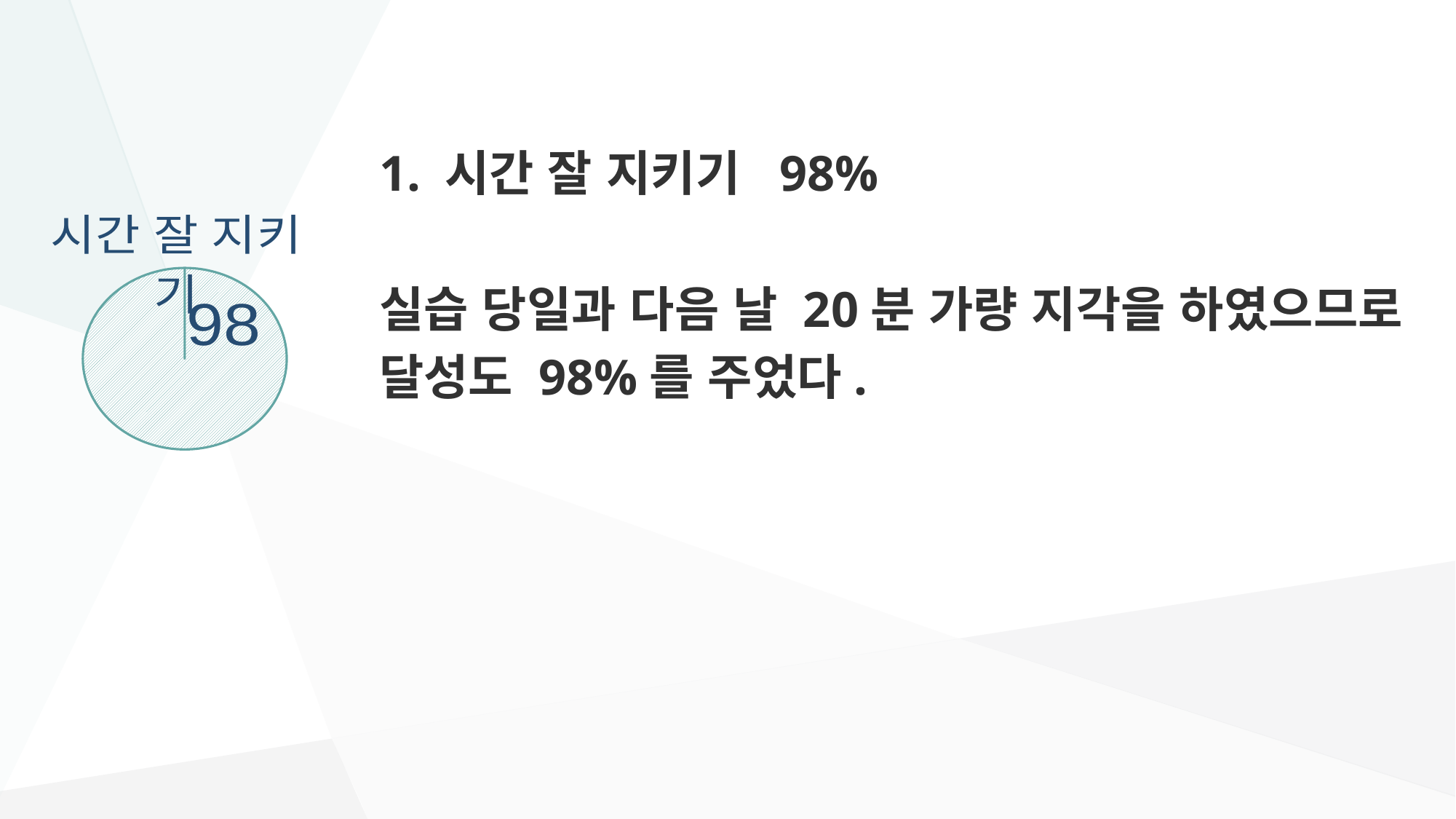
Is the value labelled on the large slice of the pie chart greater or less than 50? greater What is the title of the chart on the slide? 시간 잘 지키기 What kind of chart is shown on the slide? pie chart What value is printed as the data label on the large slice of the pie chart? 98